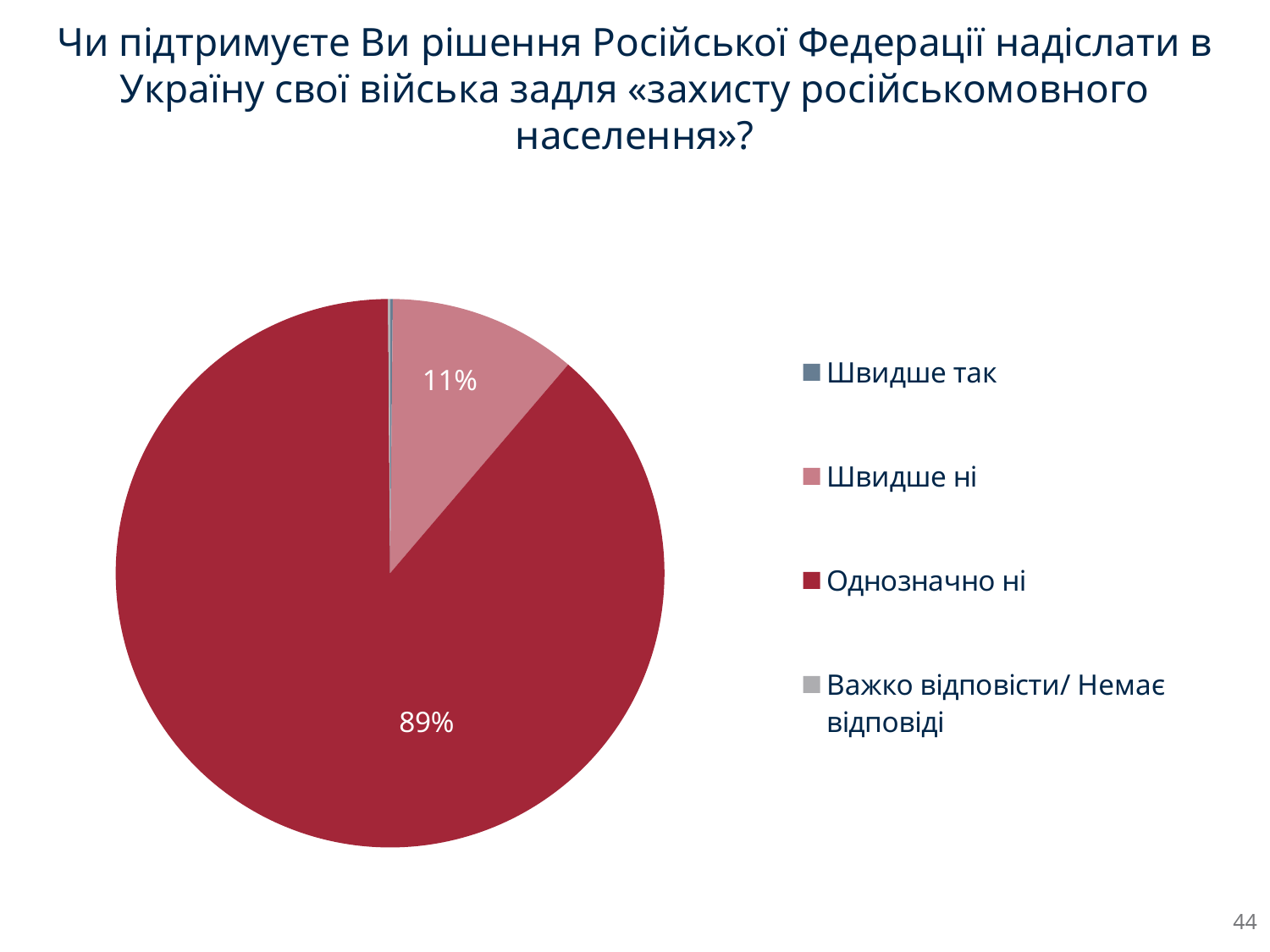
What share of respondents answered «Однозначно ні»? 89% What is the difference in percentage points between «Однозначно ні» and «Швидше ні»? 78 What share of respondents answered «Швидше ні»? 11% Which is larger, the slice for «Швидше ні» or the slice for «Однозначно ні»? Однозначно ні How many answer categories does the legend list? 4 What colour is the slice for «Однозначно ні»? dark red What kind of chart is shown on the slide? pie chart What is the combined share of «Однозначно ні» and «Швидше ні»? 100% Which legend entry is listed first? Швидше так Which answer category has the largest slice of the pie? Однозначно ні